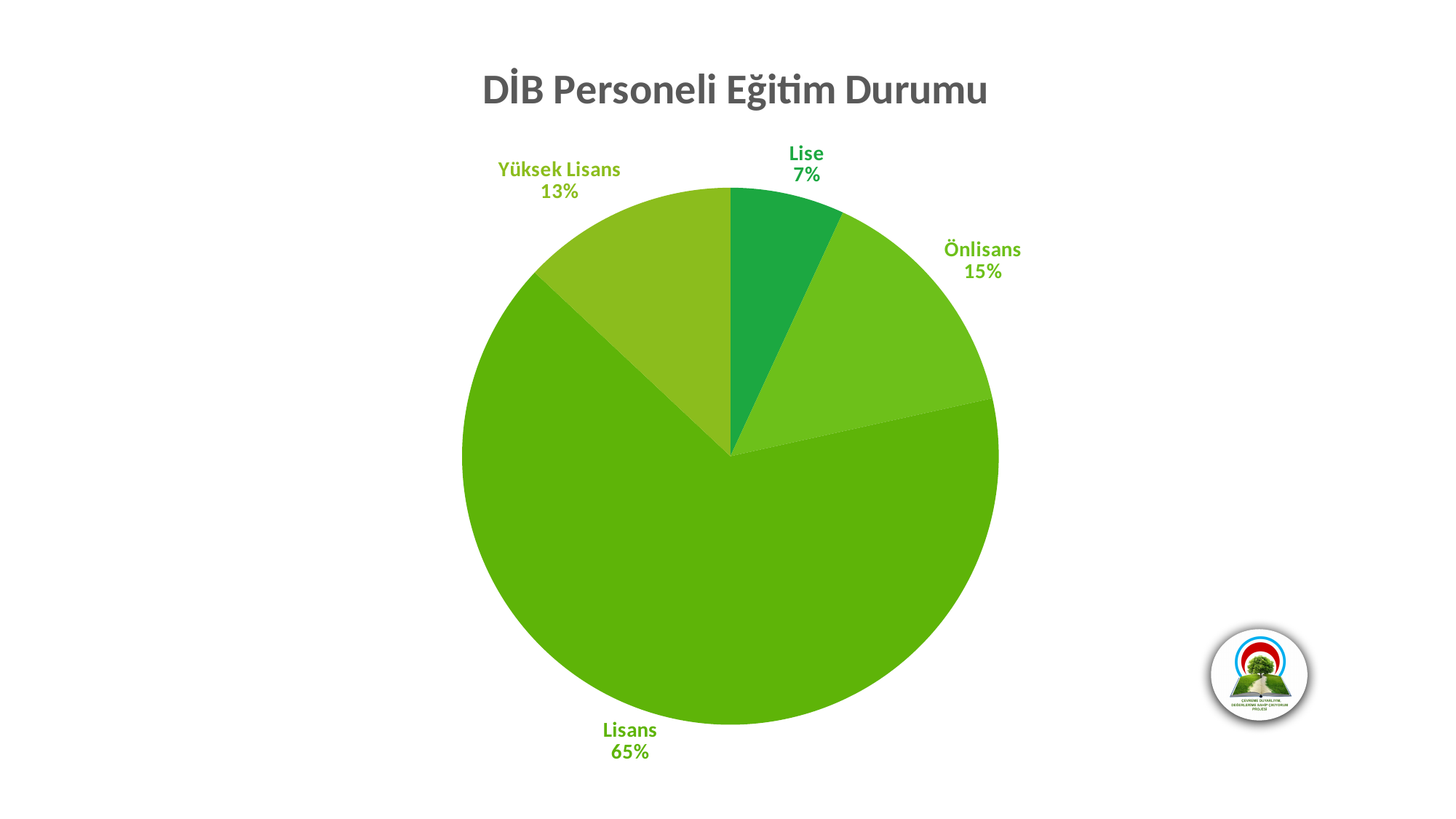
Which category has the smallest slice of the pie? Lise Which category has the largest slice of the pie? Lisans What share of the pie does Önlisans represent? 15% What share of the pie does Yüksek Lisans represent? 13% What is the difference in percentage points between Önlisans and Yüksek Lisans? 2 How many slices does the pie chart have? 4 What is the difference in percentage points between Lisans and Lise? 58 What is the title of the chart? DİB Personeli Eğitim Durumu Which is larger, the share for Önlisans or the share for Lise? Önlisans What share of the pie does Lisans represent? 65% What kind of chart is shown on the slide? pie chart